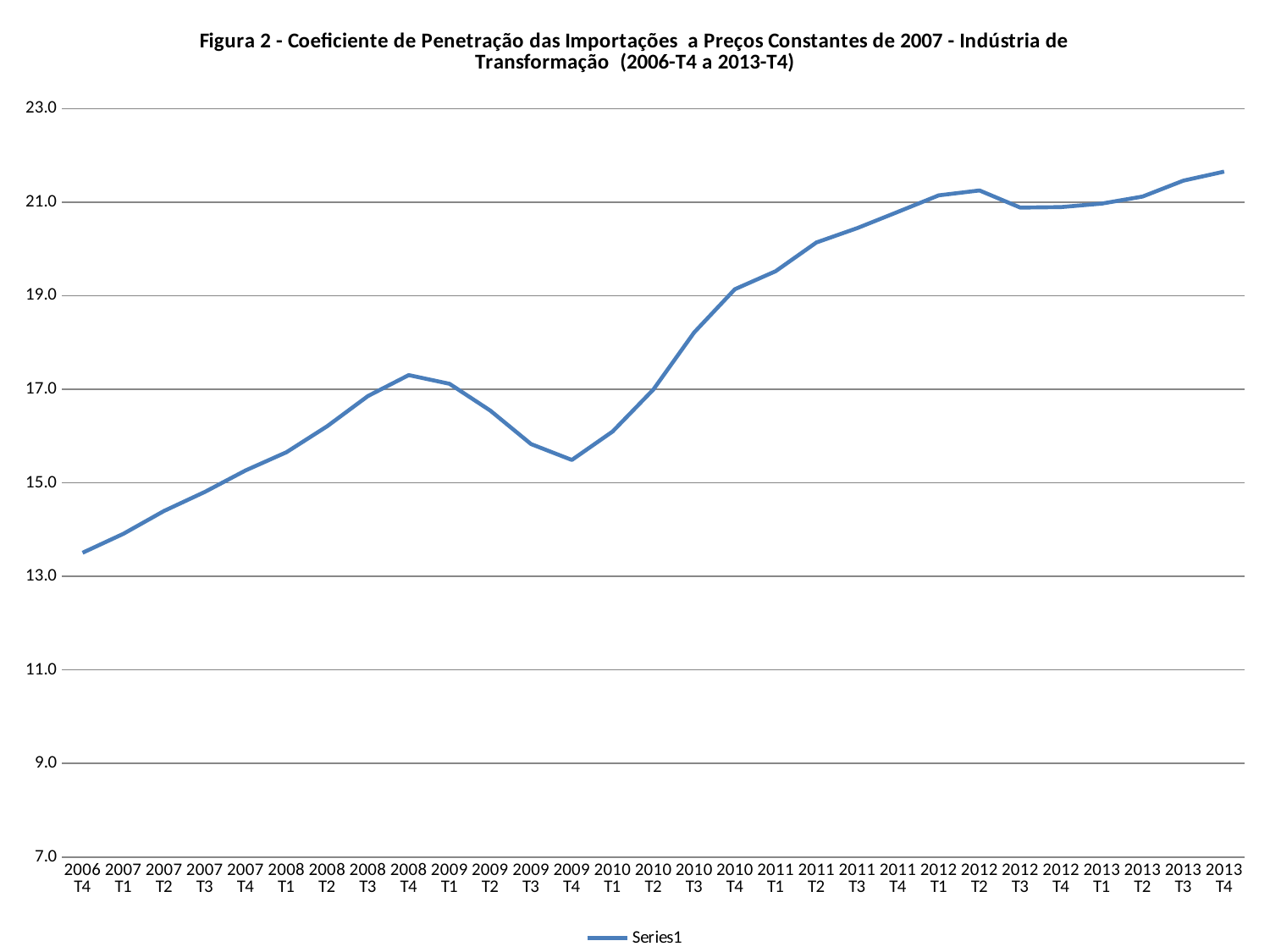
Is the value for 2013 T4 greater or less than 21.0? greater Which period has the lowest value? 2006 T4 How many data points are plotted along the x axis? 29 Do the values rise or fall between 2008 T4 and 2009 T4? fall Which period has the highest value? 2013 T4 Is the value for 2009 T4 greater or less than 17.0? less Is the value for 2011 T2 greater or less than 19.0? greater Which is larger, the value for 2008 T4 or the value for 2009 T4? 2008 T4 What kind of chart is shown on the slide? line chart How many series does the legend list? 1 What is the name of the series shown in the legend? Series1